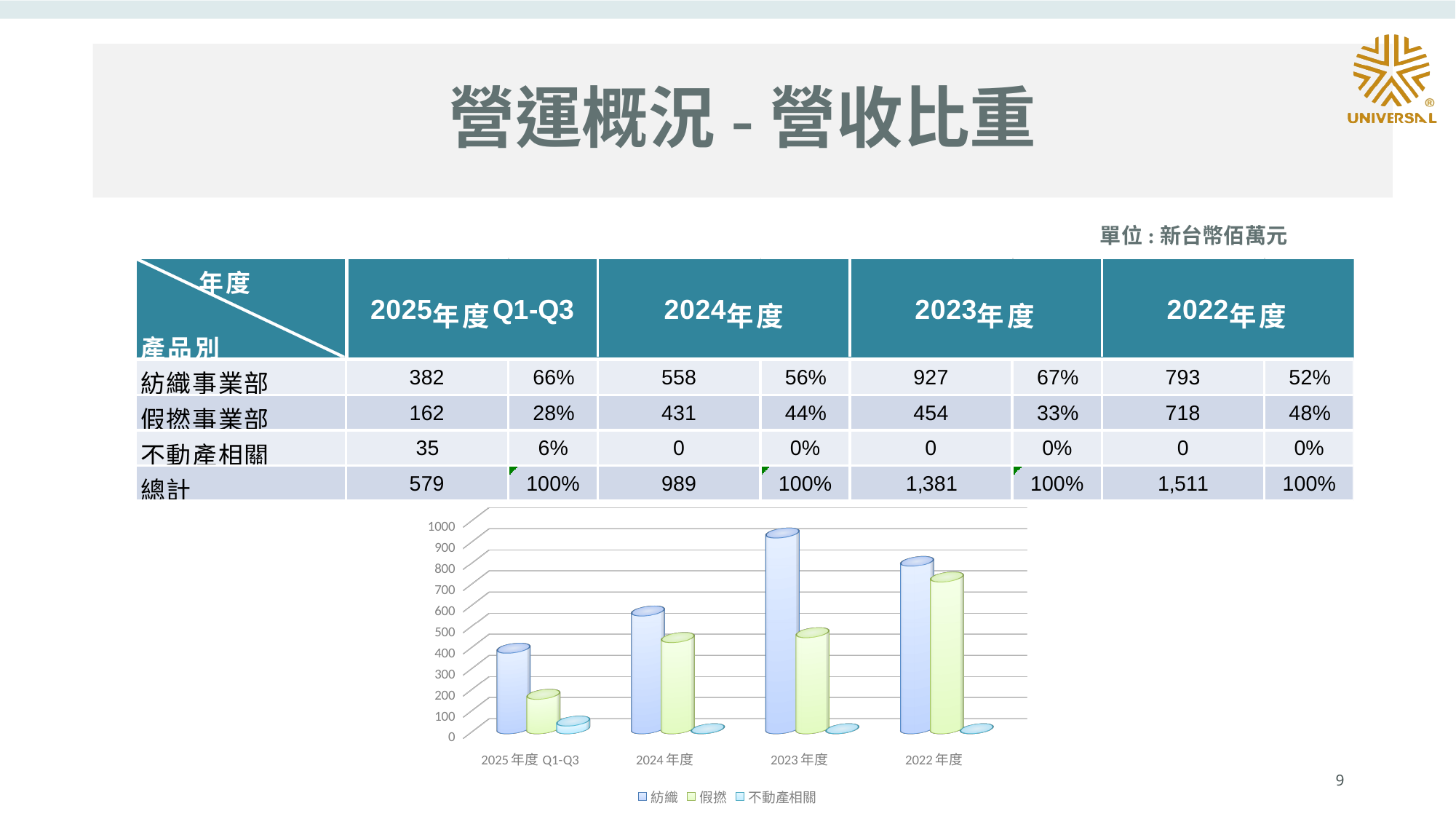
Is the 假撚 value for 2025 年度 Q1-Q3 greater or less than 200? less According to the table on the slide, what is the difference between the 紡織事業部 and 假撚事業部 values for 2023年度? 473 In 2024 年度, which is larger, the 紡織 bar or the 假撚 bar? 紡織 How many series does the chart legend list? 3 According to the table on the slide, what is the 紡織事業部 value for 2024年度? 558 Which category has the lowest 紡織 bar in the chart? 2025 年度 Q1-Q3 What kind of chart is shown on the slide? bar chart How many categories are shown on the x axis of the chart? 4 Which category has the highest 假撚 bar in the chart? 2022 年度 Is the 紡織 value for 2023 年度 greater or less than 900? greater Which category has the highest 紡織 bar in the chart? 2023 年度 Is the 紡織 value for 2024 年度 greater or less than 500? greater